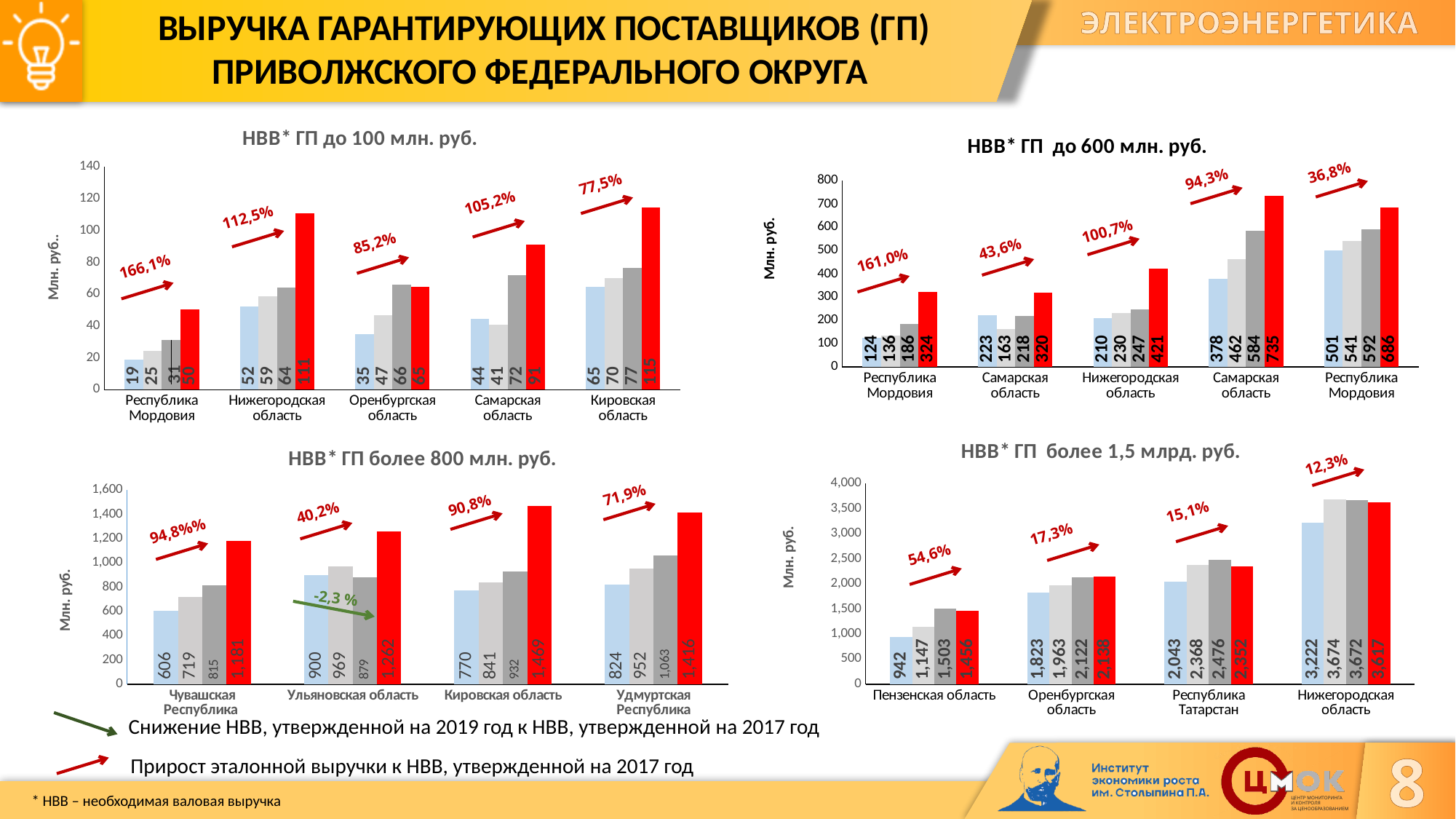
On the chart titled 'НВВ* ГП более 1,5 млрд. руб.', is the red bar for Нижегородская область greater or less than 3,000? greater On the chart titled 'НВВ* ГП до 100 млн. руб.', what is the value of the red bar for Кировская область? 115 On the chart titled 'НВВ* ГП до 100 млн. руб.', which category has the highest red bar? Кировская область On the chart titled 'НВВ* ГП более 800 млн. руб.', what percentage is shown next to the green arrow for Ульяновская область? -2,3 % On the chart titled 'НВВ* ГП более 800 млн. руб.', which category has the lowest red bar? Чувашская Республика On the chart titled 'НВВ* ГП более 800 млн. руб.', what is the value of the red bar for Кировская область? 1,469 On the chart titled 'НВВ* ГП до 100 млн. руб.', how many categories are shown on the x axis? 5 On the chart titled 'НВВ* ГП более 1,5 млрд. руб.', what is the value of the red bar for Пензенская область? 1,456 On the chart titled 'НВВ* ГП до 600 млн. руб.', what percentage is printed above the bars for Нижегородская область? 100,7% What kind of chart is used for 'НВВ* ГП более 1,5 млрд. руб.'? Bar chart On the chart titled 'НВВ* ГП до 100 млн. руб.', what is the difference between the red bar (50) and the first light-blue bar (19) for Республика Мордовия? 31 On the chart titled 'НВВ* ГП до 600 млн. руб.', what is the value of the red bar for Нижегородская область? 421